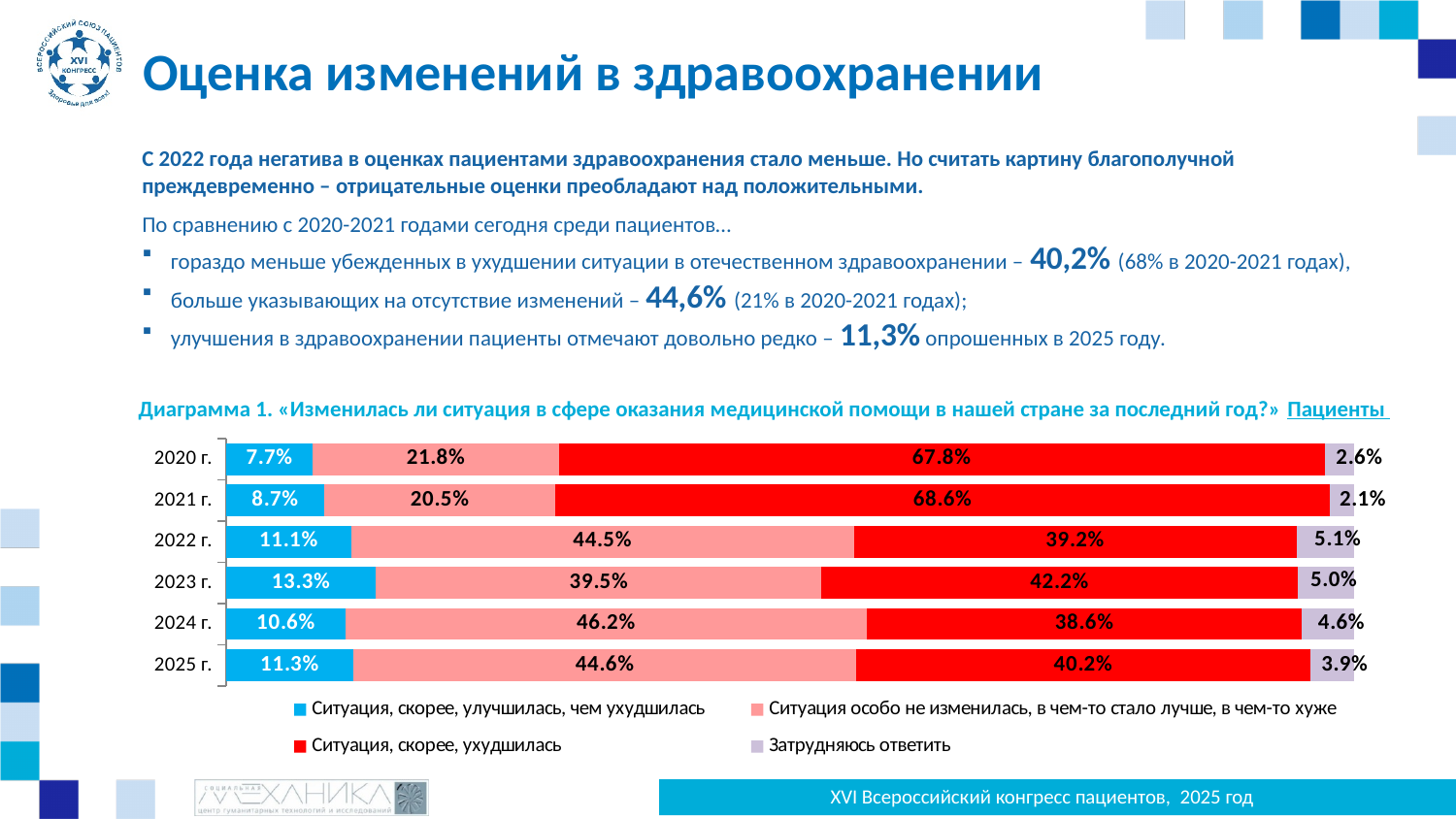
How many series does the chart legend list? 4 What is the value for «Затрудняюсь ответить» in 2023 г.? 5.0% Overall, does the share of «Ситуация, скорее, ухудшилась» rise or fall from 2020 г. to 2025 г.? Fall In which year is the share of «Затрудняюсь ответить» the lowest? 2021 г. What type of chart is shown on the slide? Stacked bar chart In which year is the share of «Ситуация, скорее, улучшилась, чем ухудшилась» the highest? 2023 г. By how many percentage points does the share of «Ситуация, скорее, ухудшилась» in 2021 г. exceed that in 2020 г.? 0.8 percentage points In 2025 г., what is the difference between the share of «Ситуация особо не изменилась» and the share of «Ситуация, скорее, улучшилась»? 33.3 percentage points How many years (categories) are shown in the chart? 6 What is the value for «Ситуация особо не изменилась, в чем-то стало лучше, в чем-то хуже» in 2020 г.? 21.8% Which year has a larger share of «Ситуация особо не изменилась»: 2022 г. or 2024 г.? 2024 г. What percentage of patients in 2025 г. answered «Ситуация, скорее, ухудшилась»? 40.2%